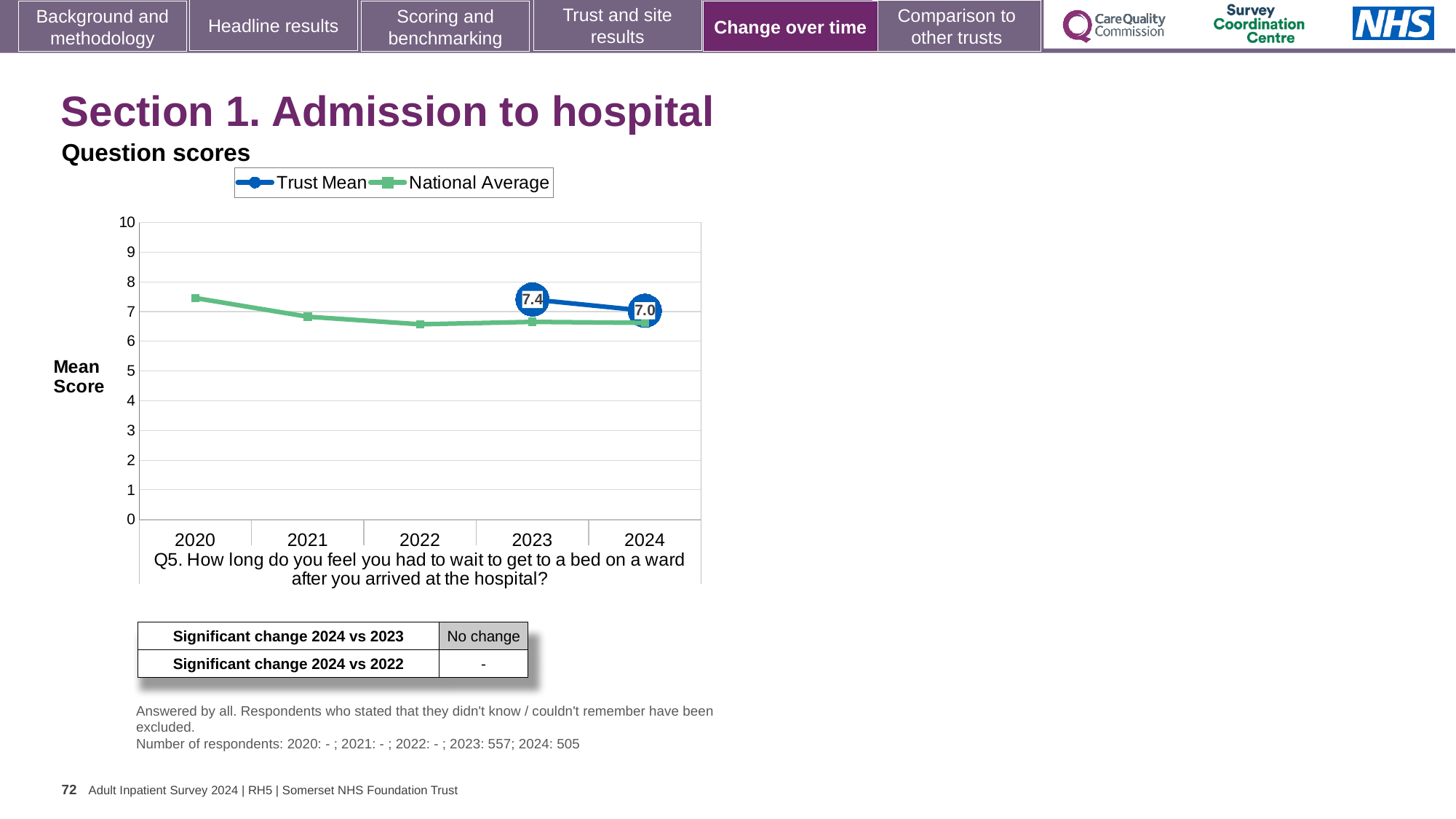
What kind of chart is shown? Line chart Is the National Average value for 2020 greater or less than 7? greater How many series does the legend list? 2 What is the Trust Mean value for 2024? 7.0 Does the Trust Mean rise or fall from 2023 to 2024? Fall Is the Trust Mean value for 2023 greater or less than the National Average value for 2023? greater What is the label on the y axis of the chart? Mean Score What is the Trust Mean value for 2023? 7.4 Which year has the higher Trust Mean, 2023 or 2024? 2023 How many years are shown on the x axis? 5 What is the difference between the Trust Mean in 2023 and in 2024? 0.4 Is the National Average value for 2022 greater or less than 7? less